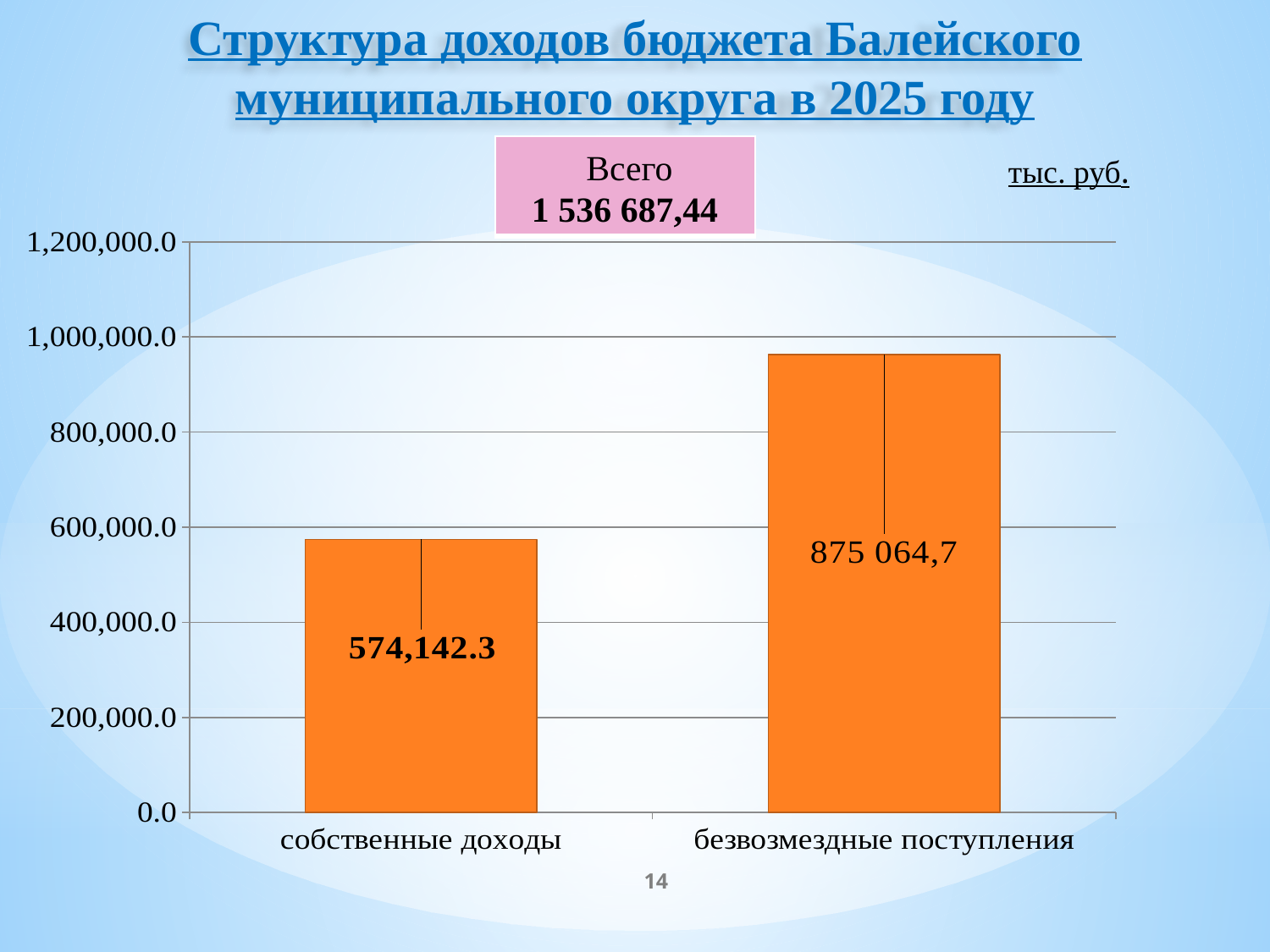
What is the value for безвозмездные поступления? 875 064,7 Which category has the lowest value? собственные доходы Which is larger, собственные доходы or безвозмездные поступления? безвозмездные поступления Which category has the highest value? безвозмездные поступления In what units are the values on the chart given? тыс. руб. Is the value for собственные доходы greater or less than 600,000.0? less How many categories are shown on the chart? 2 What is the value for собственные доходы? 574,142.3 What kind of chart is shown on the slide? bar chart Is the value for безвозмездные поступления greater or less than 800,000.0? greater What total (Всего) is shown above the chart? 1 536 687,44